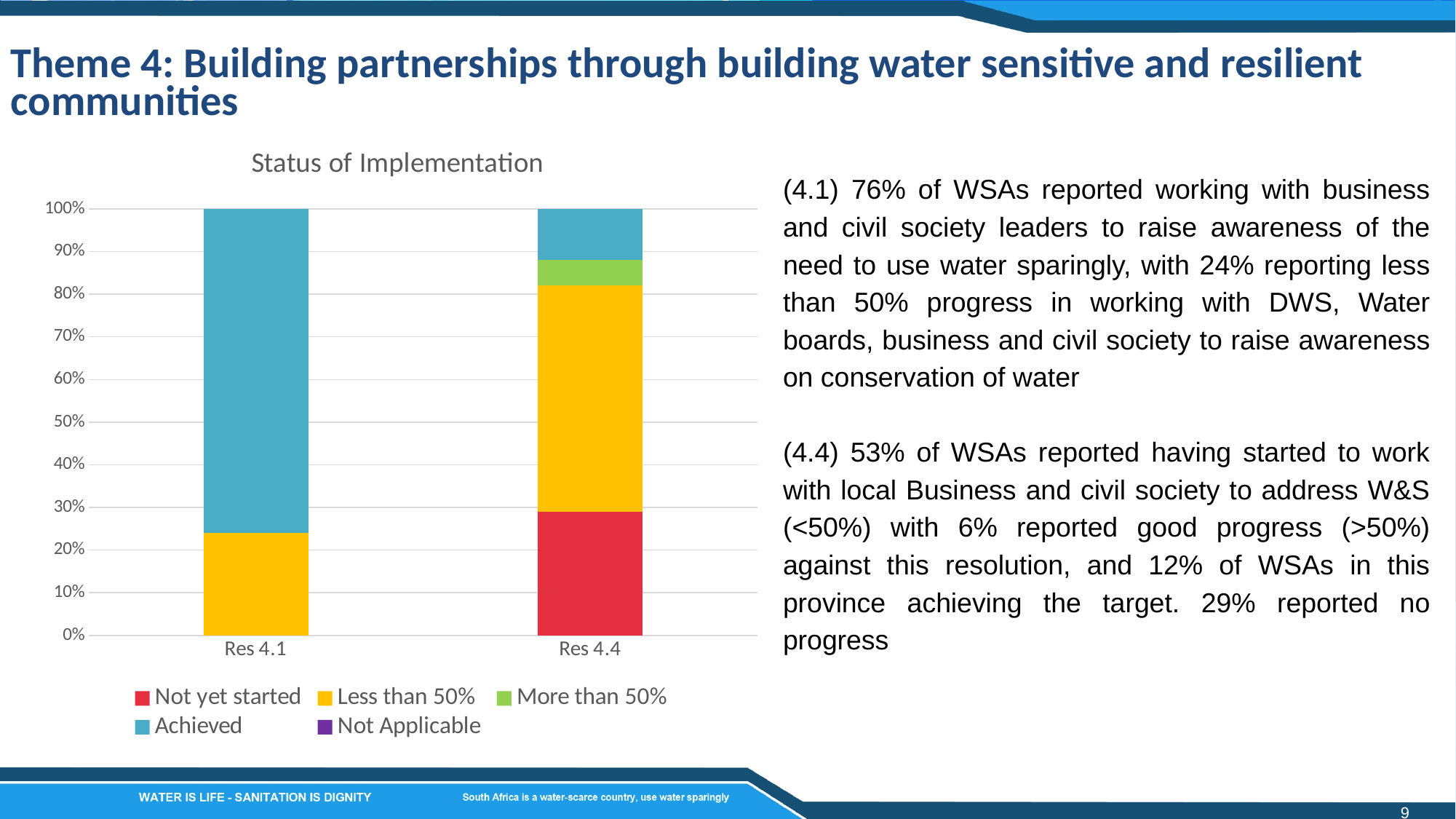
Is the 'Less than 50%' share for Res 4.1 greater or less than 30%? less Is the 'More than 50%' share for Res 4.4 greater or less than 10%? less How many categories are shown on the x axis of the chart? 2 What kind of chart is shown on the slide? Stacked bar chart Is the 'Achieved' share for Res 4.1 greater or less than 70%? greater Which colour represents 'Not yet started' in the chart? Red What is the title of the chart? Status of Implementation Which category has the larger 'Achieved' share, Res 4.1 or Res 4.4? Res 4.1 How many series does the chart legend list? 5 Which category has the larger 'Less than 50%' share, Res 4.1 or Res 4.4? Res 4.4